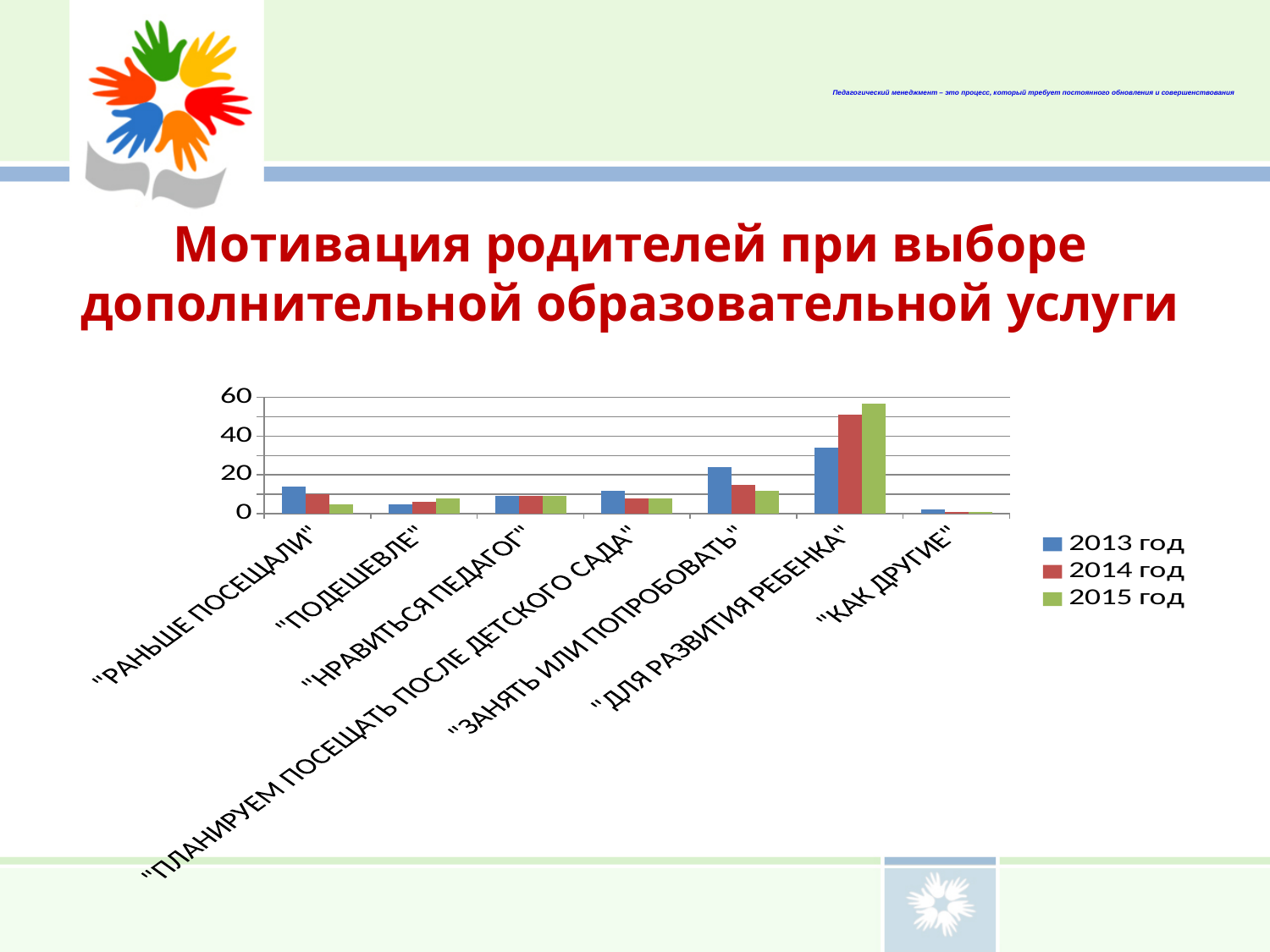
Is the 2013 год value for "ДЛЯ РАЗВИТИЯ РЕБЕНКА" greater or less than 20? greater For "ДЛЯ РАЗВИТИЯ РЕБЕНКА", do the values rise or fall from 2013 год to 2015 год? rise Is the 2013 год value for "РАНЬШЕ ПОСЕЩАЛИ" greater or less than 20? less Which category has the lowest value for the 2013 год series? "КАК ДРУГИЕ" For "РАНЬШЕ ПОСЕЩАЛИ", do the values rise or fall from 2013 год to 2015 год? fall Which years are listed in the chart legend? 2013 год, 2014 год, 2015 год Which category has the highest value for the 2015 год series? "ДЛЯ РАЗВИТИЯ РЕБЕНКА" How many series does the chart legend list? 3 How many categories are shown on the x axis of the chart? 7 For "ДЛЯ РАЗВИТИЯ РЕБЕНКА", which is larger: the 2013 год value or the 2015 год value? 2015 год Is the 2015 год value for "ДЛЯ РАЗВИТИЯ РЕБЕНКА" greater or less than 40? greater What kind of chart is shown on the slide? bar chart